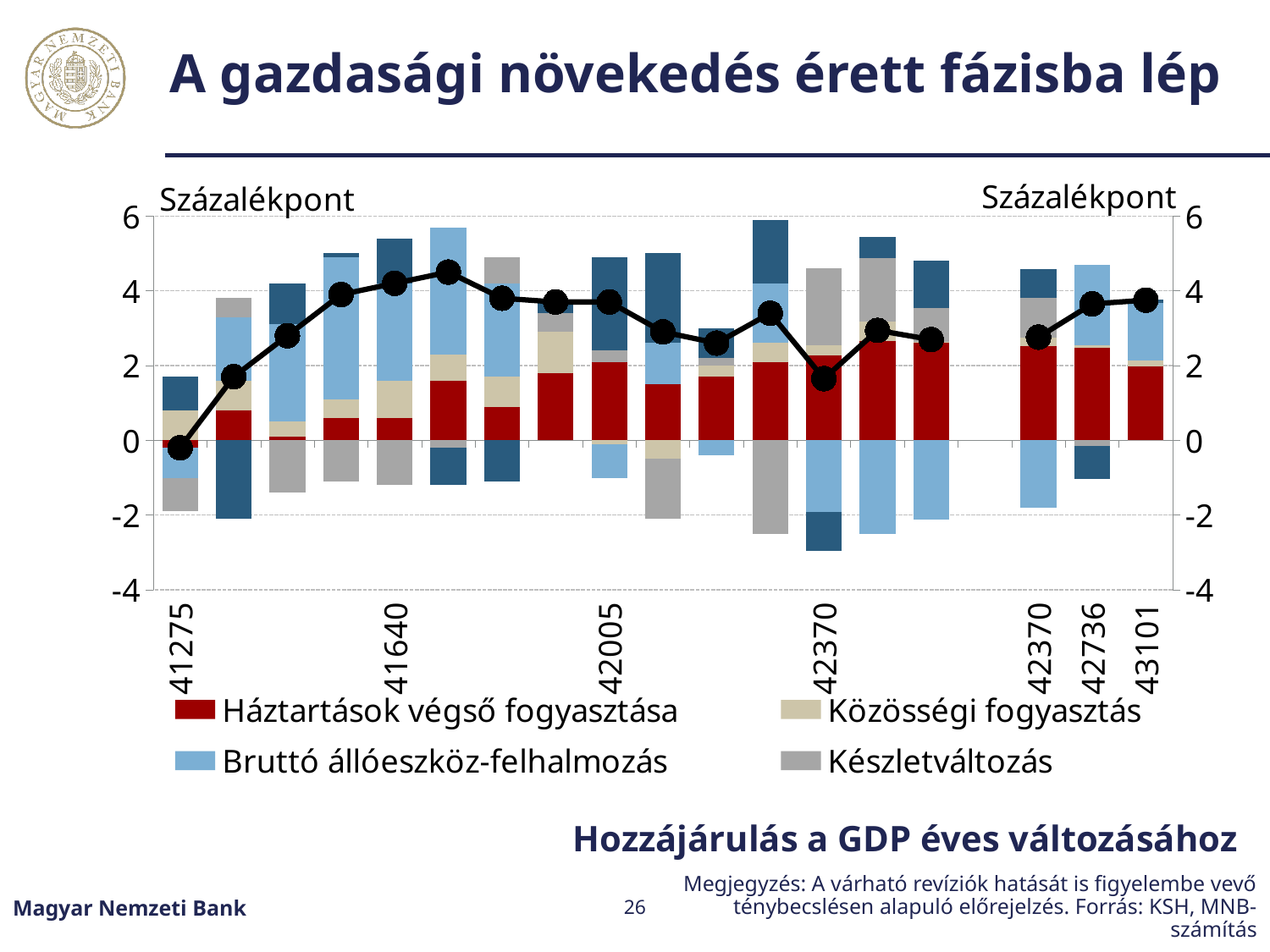
Is the value of the black line at 43101 greater or less than 2? greater What is the title of the slide containing the chart? A gazdasági növekedés érett fázisba lép Is the value of the black line at 41275 greater or less than 2? less Is the value of the black line at 41640 greater or less than 2? greater How many series does the legend list? 4 Does the black line rise or fall between 41275 and 41640? rise What unit is shown on the vertical axes of the chart? Százalékpont Does the black line rise or fall between 42005 and the first 42370? fall What kind of chart is shown on the slide? combination bar and line chart Which is larger, the black line value at 42005 or at the first 42370? 42005